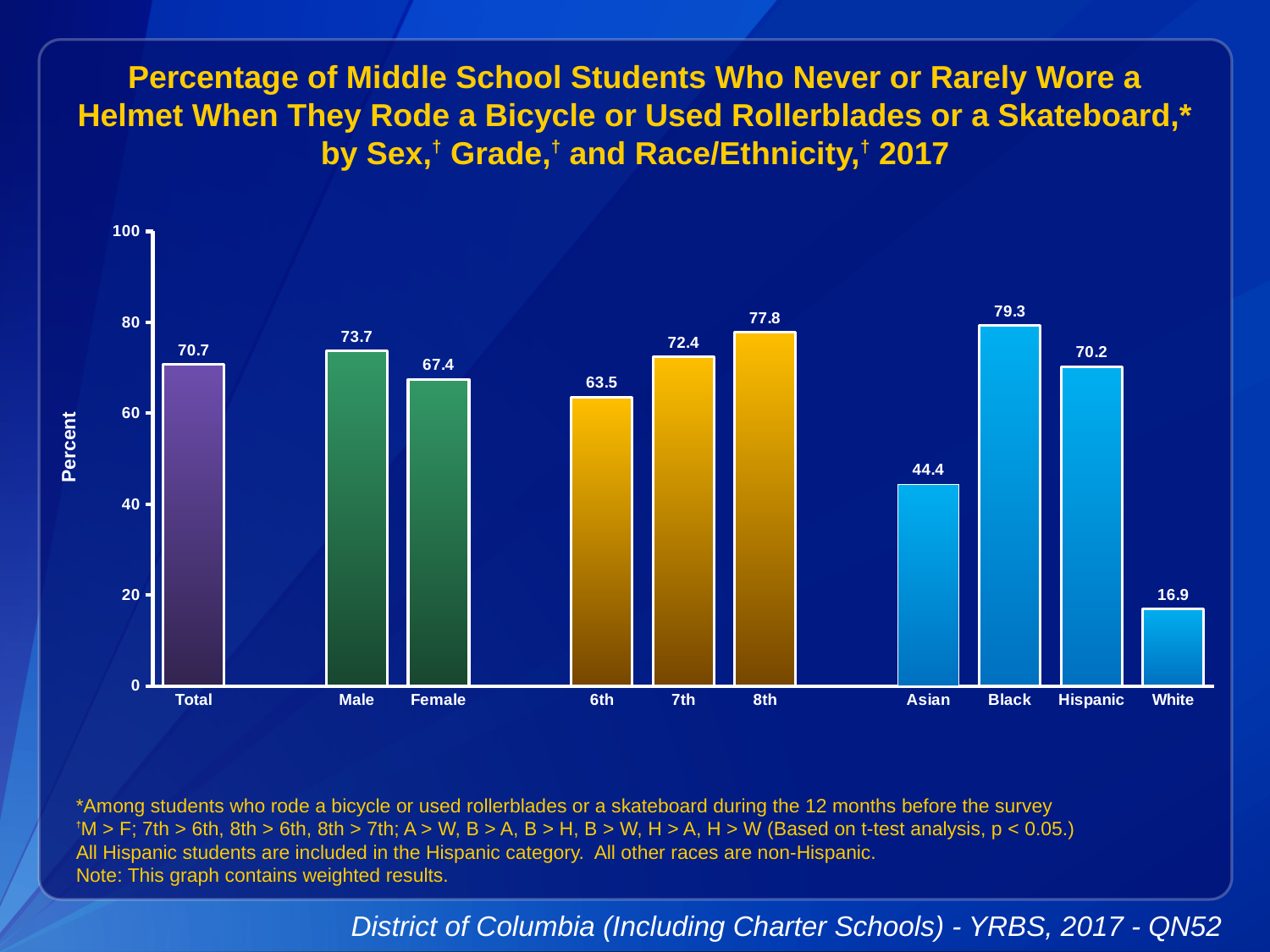
What is the value for 8th grade? 77.8 What is the difference between the values for Male and Female? 6.3 Which is larger, the value for 7th grade or the value for 6th grade? 7th How many categories are shown on the x axis? 10 What is the label of the y axis? Percent Is the value for Asian greater or less than 60? less Which category has the lowest value? White Which category has the highest value? Black What is the value for Female? 67.4 What is the value for White? 16.9 What is the value for Total? 70.7 What kind of chart is this? bar chart